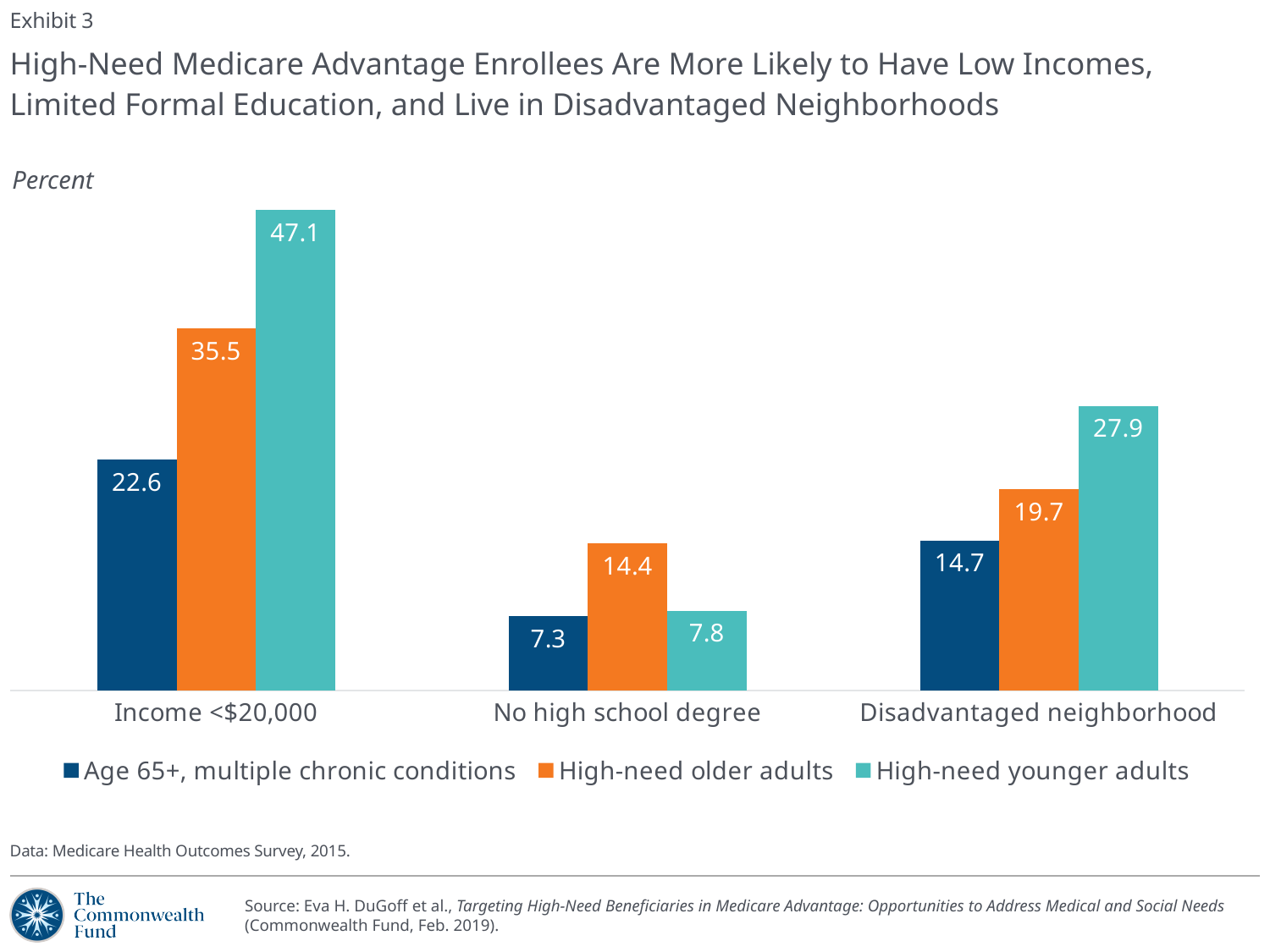
What is the difference between High-need younger adults and Age 65+, multiple chronic conditions in the Income <$20,000 category? 24.5 How many series does the legend list? 3 How many categories are shown on the x axis? 3 Which is larger in the Disadvantaged neighborhood category: High-need older adults or High-need younger adults? High-need younger adults Which series has the lowest value in the No high school degree category? Age 65+, multiple chronic conditions What is the value for High-need older adults in the Disadvantaged neighborhood category? 19.7 What kind of chart is shown on the slide? Bar chart What is the value for Age 65+, multiple chronic conditions in the No high school degree category? 7.3 Which series has the highest value in the Income <$20,000 category? High-need younger adults What unit is the chart measured in, according to the label above the chart? Percent What is the value for High-need younger adults in the Income <$20,000 category? 47.1 What is the difference between High-need older adults and High-need younger adults in the No high school degree category? 6.6